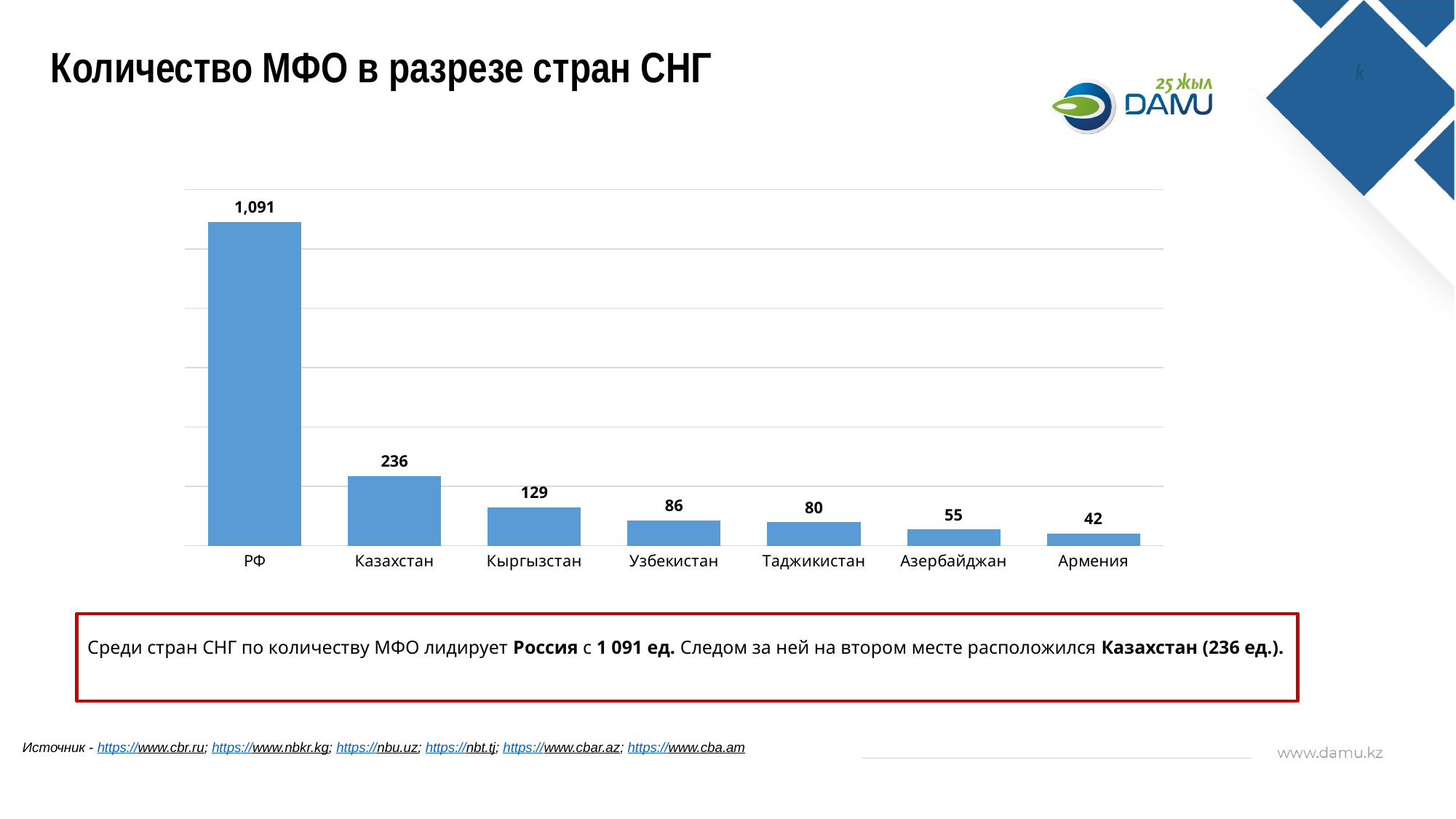
Which country has the highest number of МФО? РФ Do the values rise or fall from left to right along the x axis? Fall What is the value for Узбекистан? 86 How many countries are shown on the chart? 7 Which is larger, the value for Азербайджан or the value for Таджикистан? Таджикистан What is the difference between the values for Кыргызстан and Таджикистан? 49 What is the value for Казахстан? 236 What is the difference between the values for РФ and Казахстан? 855 What is the value for Армения? 42 Which country has the lowest number of МФО? Армения What kind of chart is shown on the slide? Bar chart What is the title of the slide? Количество МФО в разрезе стран СНГ